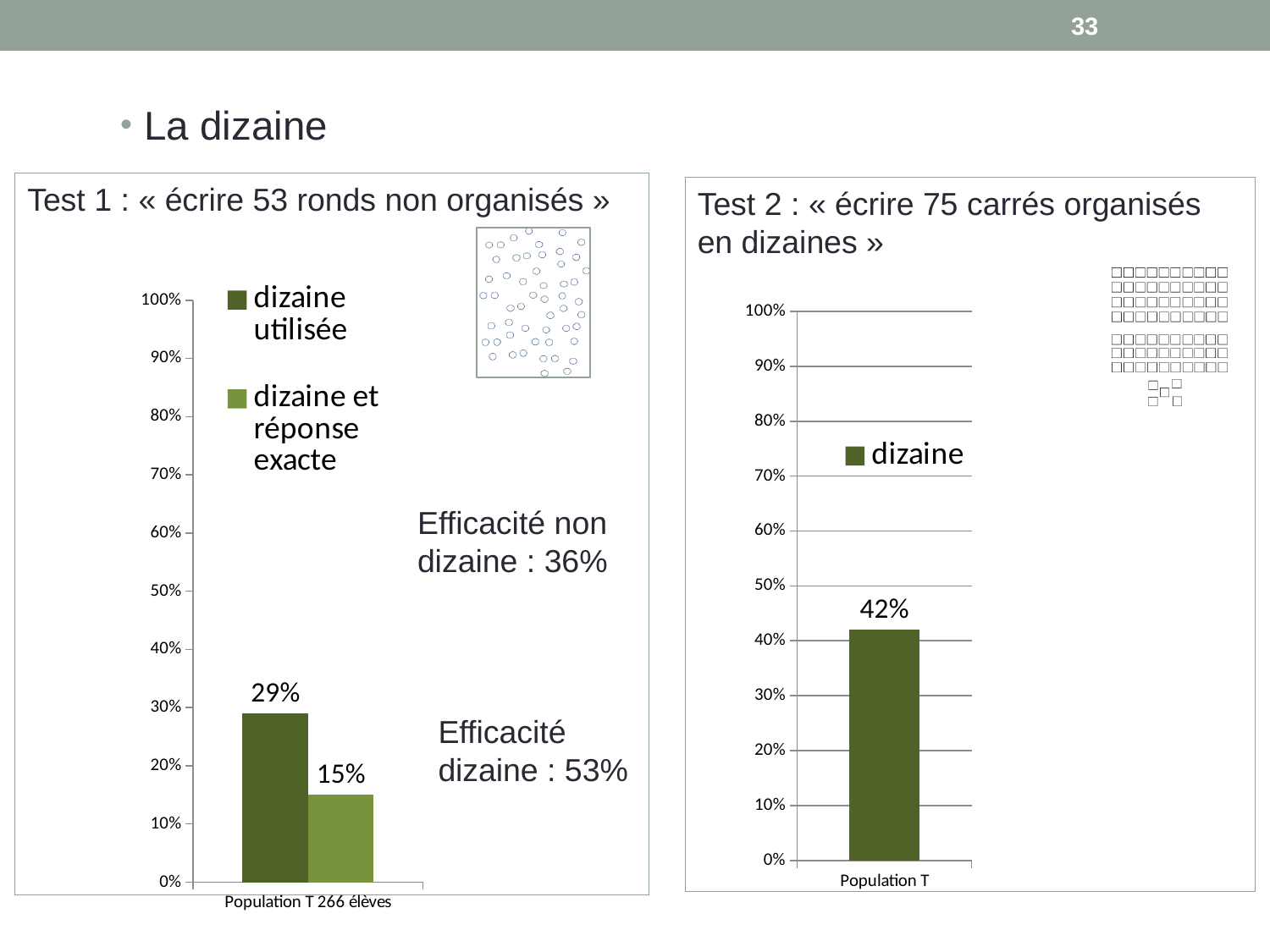
In the Test 1 chart on the left, what is the value for "dizaine utilisée"? 29% In the Test 2 chart on the right, how many series does the legend list? 1 In the Test 1 chart on the left, what is the difference between "dizaine utilisée" and "dizaine et réponse exacte"? 14% In the Test 1 chart on the left, what is the value for "dizaine et réponse exacte"? 15% In the Test 1 chart on the left, what is the category label on the x axis? Population T 266 élèves In the Test 1 chart on the left, how many series does the legend list? 2 In the Test 2 chart on the right, is the value for "dizaine" greater or less than 50%? less In the Test 1 chart on the left, which series has the lowest value? dizaine et réponse exacte Is the "dizaine" value in the Test 2 chart on the right larger than the "dizaine utilisée" value in the Test 1 chart on the left? Yes In the Test 2 chart on the right, what is the value for "dizaine" for Population T? 42% What kind of chart is the Test 2 chart on the right? bar chart In the Test 1 chart on the left, which series has the higher value, "dizaine utilisée" or "dizaine et réponse exacte"? dizaine utilisée